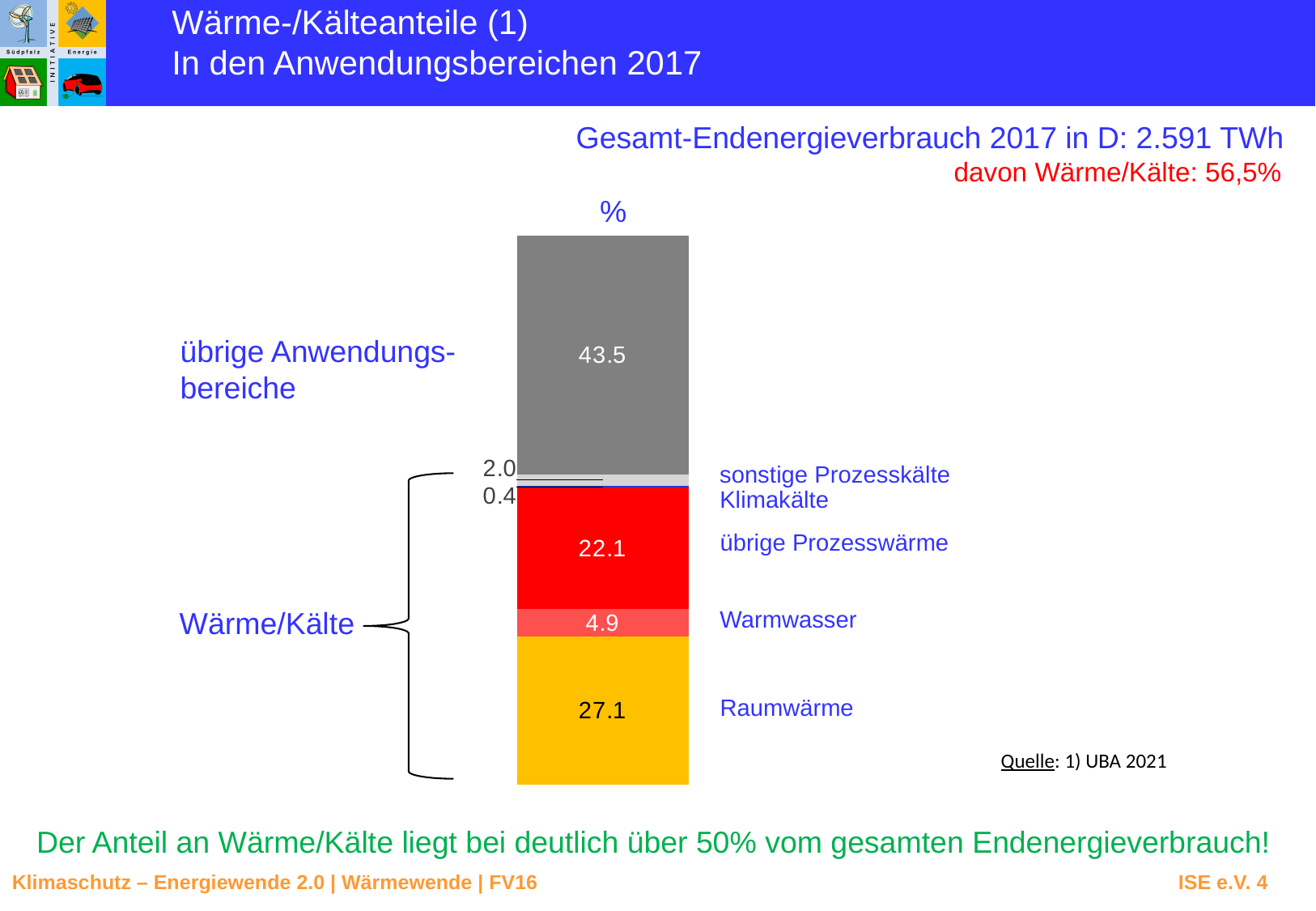
What kind of chart is shown on the slide? Stacked bar chart Which segment of the stacked bar has the largest value? übrige Anwendungsbereiche Which segment of the stacked bar has the smallest value? Klimakälte What is the value for übrige Anwendungsbereiche? 43.5 How many segments does the stacked bar contain? 6 What is the value for Warmwasser? 4.9 What is the value for Raumwärme in the stacked bar? 27.1 What is the value for Klimakälte? 0.4 What is the value for übrige Prozesswärme? 22.1 Which is larger, the value for Raumwärme or the value for übrige Prozesswärme? Raumwärme What is the difference between the values for Raumwärme and Warmwasser? 22.2 What is the total of the segments grouped under Wärme/Kälte (sonstige Prozesskälte, Klimakälte, übrige Prozesswärme, Warmwasser, Raumwärme)? 56.5